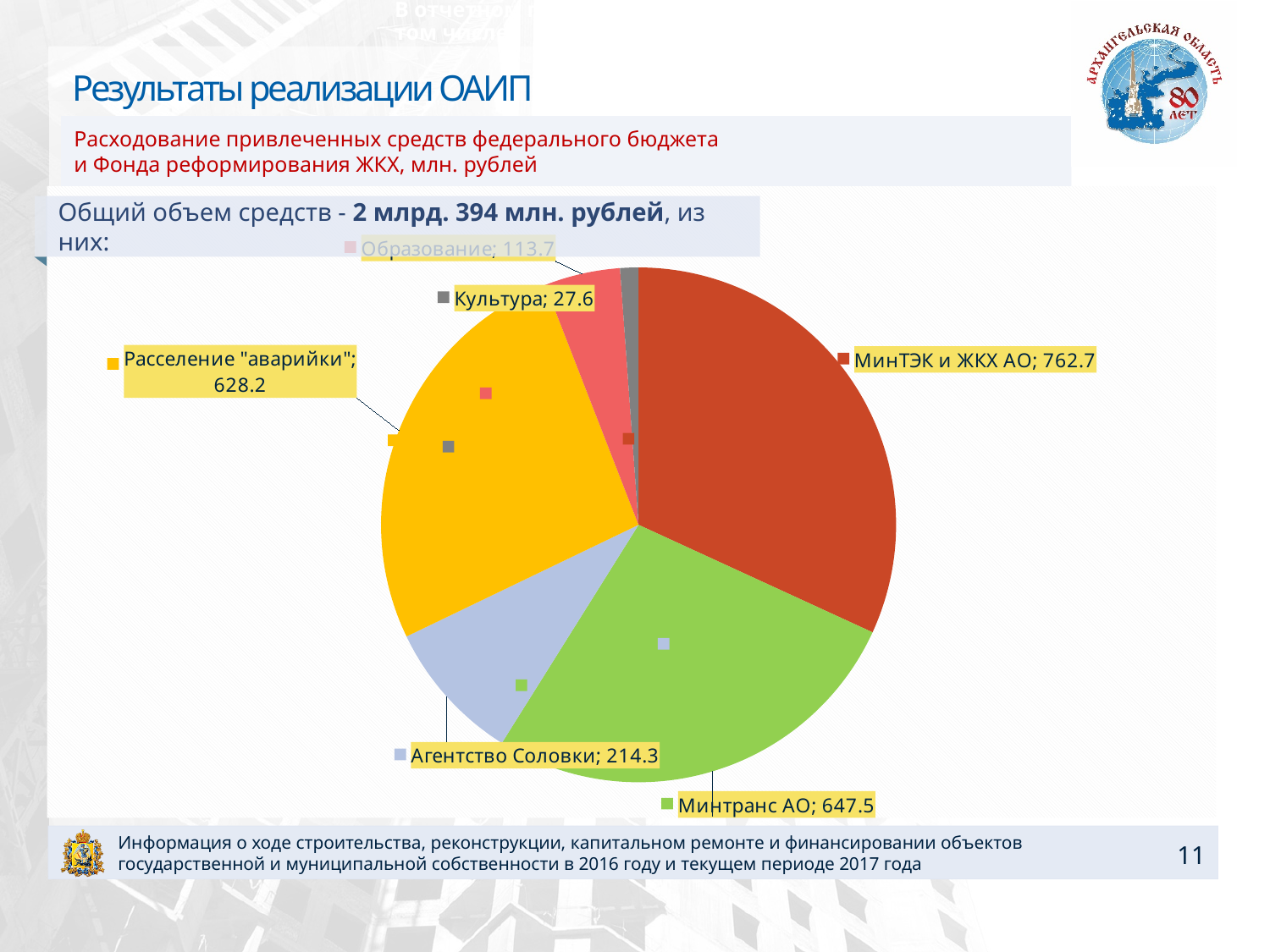
What is the value for Агентство Соловки? 214.3 What is the value for Минтранс АО? 647.5 Which category has the largest slice of the pie? МинТЭК и ЖКХ АО Which category has the smallest slice of the pie? Культура What kind of chart is shown on the slide? pie chart What is the difference between the values for Образование and Культура? 86.1 Which is larger, the value for Минтранс АО or the value for Расселение "аварийки"? Минтранс АО What total amount of funds does the slide state the pie chart represents? 2 млрд. 394 млн. рублей What is the value for МинТЭК и ЖКХ АО? 762.7 What is the difference between the values for МинТЭК и ЖКХ АО and Минтранс АО? 115.2 How many categories (slices) does the pie chart have? 6 What is the value for Культура? 27.6